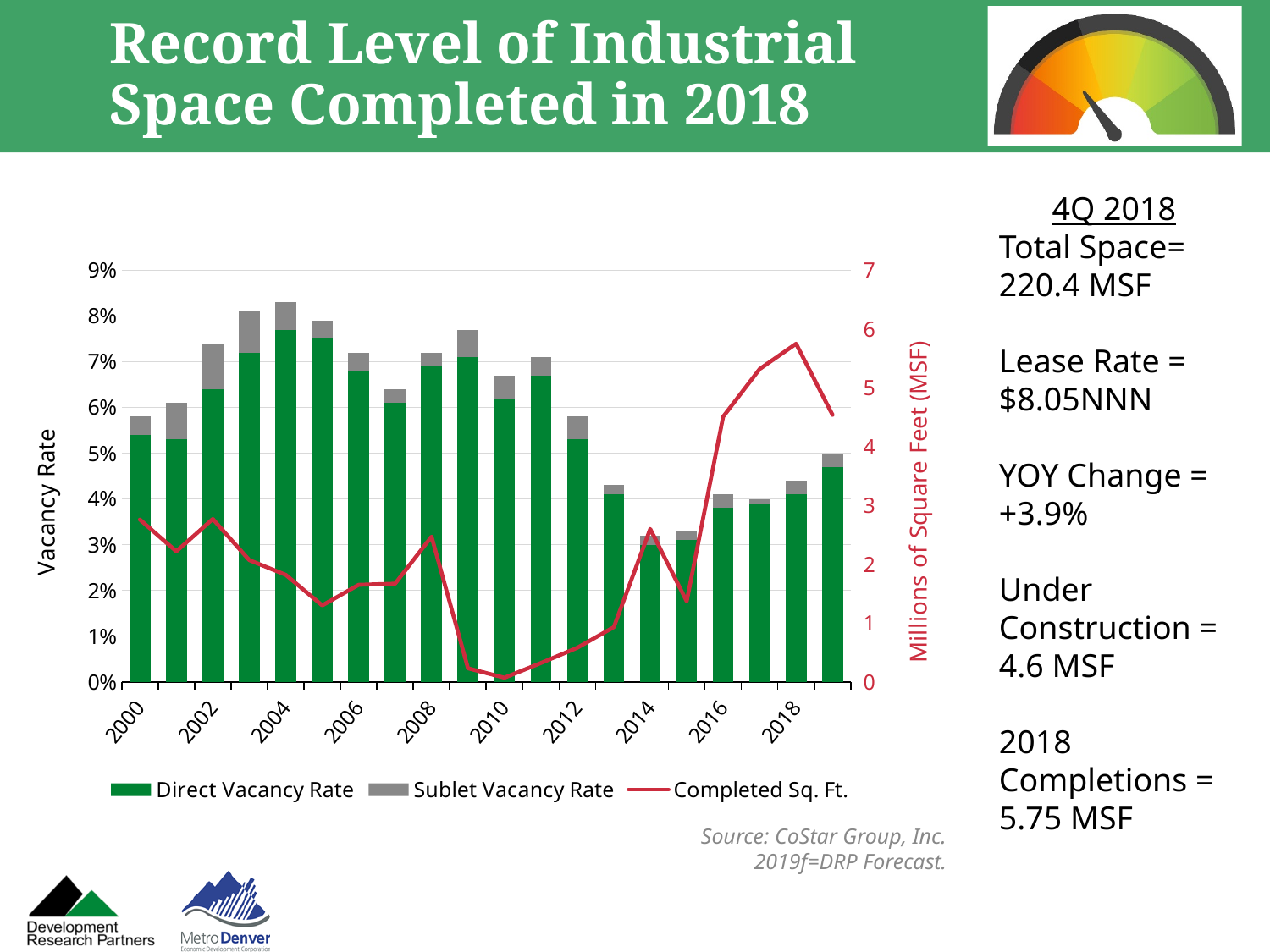
In which year does the Completed Sq. Ft. line reach its lowest point? 2010 Is the Direct Vacancy Rate for 2015 greater or less than 4%? less What is the title of the left vertical axis? Vacancy Rate Is the Completed Sq. Ft. value for 2018 greater or less than 5? greater Does the Completed Sq. Ft. line rise or fall from 2015 to 2018? rise Is the Direct Vacancy Rate for 2004 greater or less than 7%? greater How many series does the chart legend list? 3 What is the title of the right vertical axis? Millions of Square Feet (MSF) Which year has the larger Direct Vacancy Rate, 2003 or 2013? 2003 In which year does the Completed Sq. Ft. line reach its highest point? 2018 In which year is the total stacked vacancy rate (direct plus sublet) highest? 2004 What kind of chart is shown on the slide? A combined bar and line chart